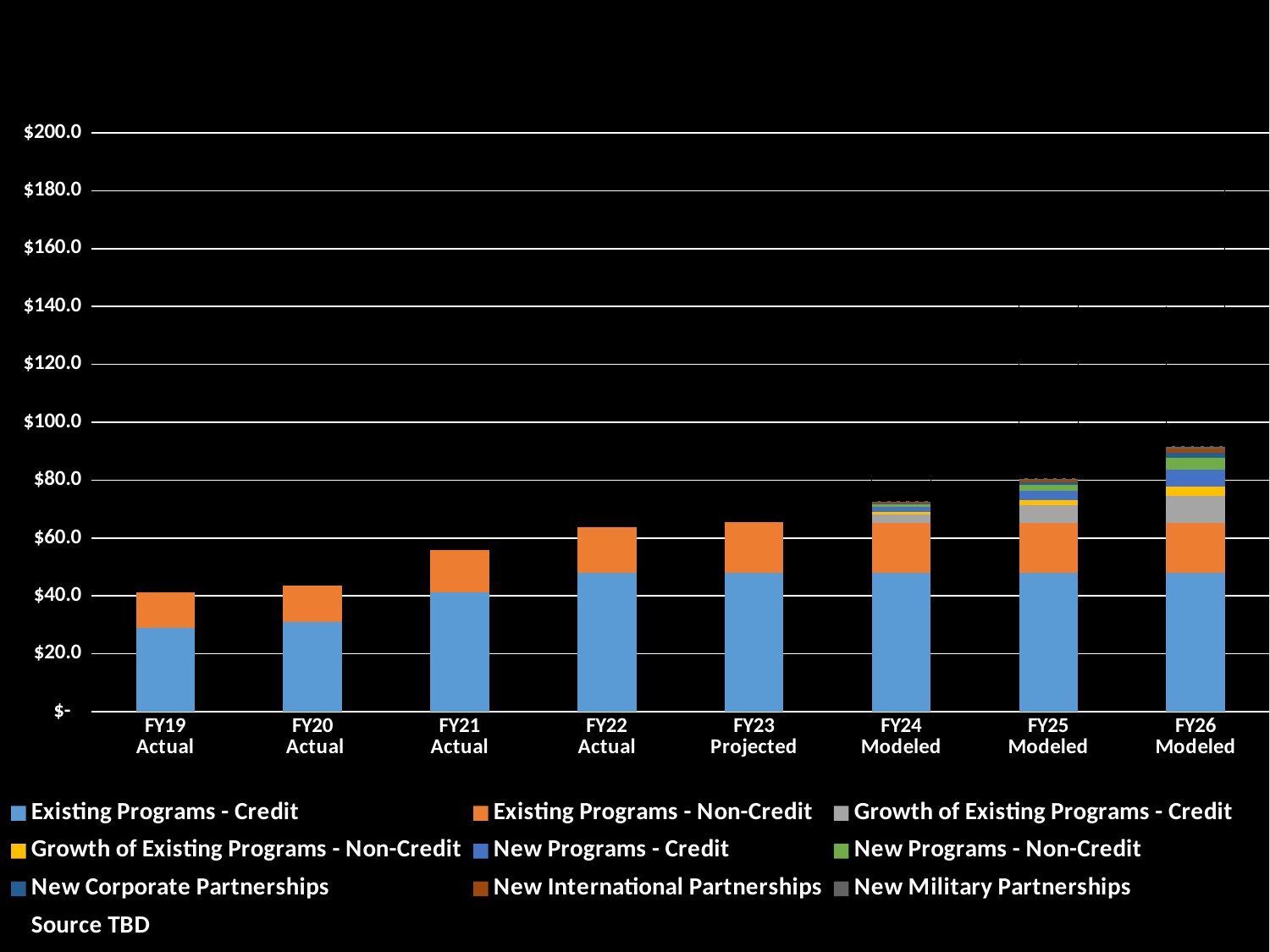
Is the Existing Programs - Credit segment for FY19 Actual greater or less than $20.0? greater Which has the taller total bar, FY20 Actual or FY22 Actual? FY22 Actual Which fiscal year has the shortest stacked bar? FY19 Actual How many series does the legend list? 9 Is the total stacked bar for FY21 Actual greater or less than $60.0? less Is the total stacked bar for FY26 Modeled greater or less than $100.0? less How many fiscal-year categories are shown on the x axis? 8 What kind of chart is shown on the slide? stacked bar chart What source note is printed below the legend? Source TBD Do the total bar heights rise or fall from FY19 Actual to FY26 Modeled? rise Which fiscal year has the tallest stacked bar? FY26 Modeled